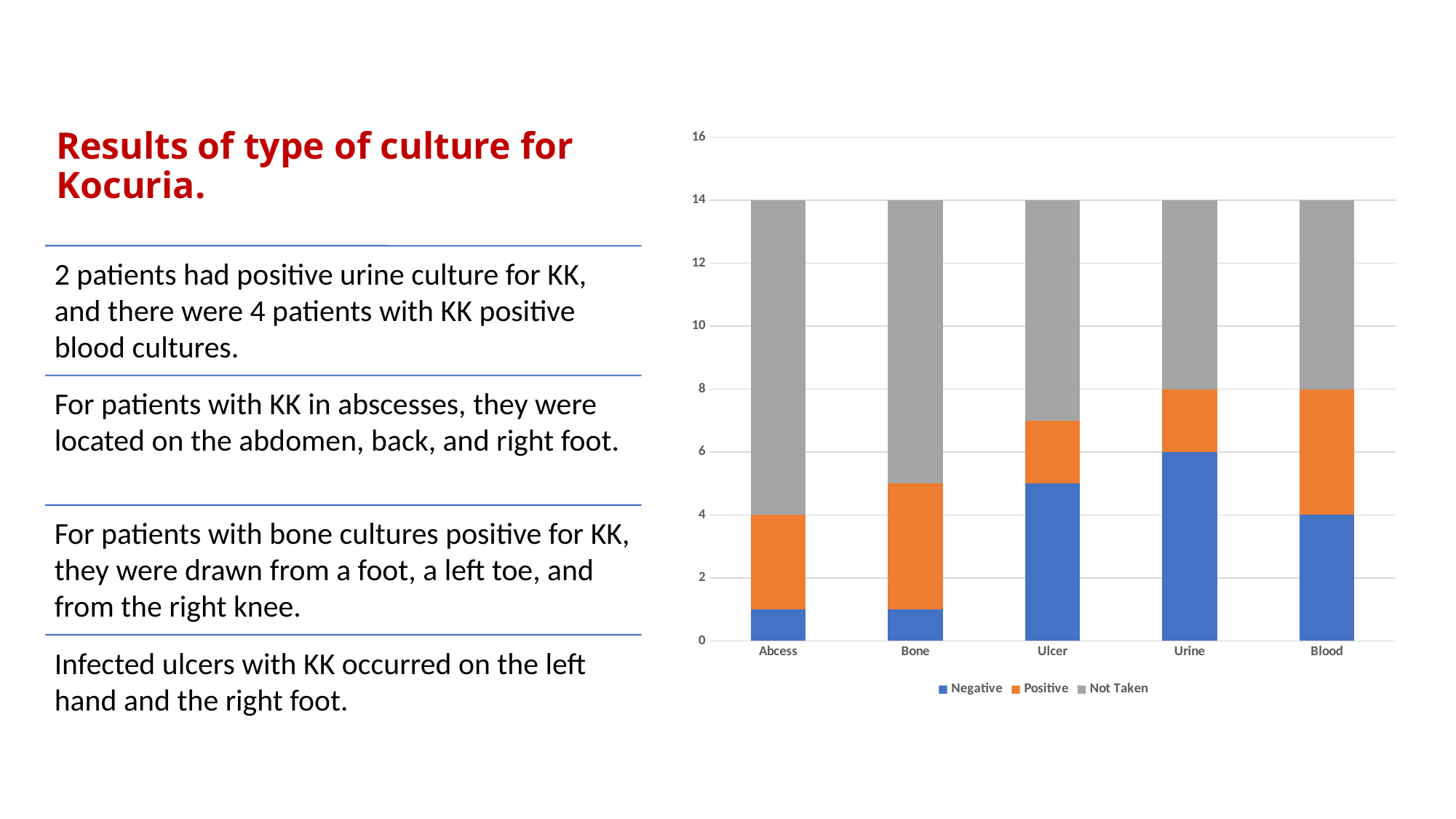
Which series is shown in gray in the chart? Not Taken Which category has the highest Negative value? Urine What is the Negative value for Urine? 6 Which series is listed first in the chart legend? Negative How many series does the chart legend list? 3 Is the Not Taken value for Abcess greater or less than 8? greater How many categories are shown on the x axis of the chart? 5 What kind of chart is shown on the slide? Stacked bar chart What is the total height of the stacked bar for Urine? 14 Which has the larger Negative value, Urine or Blood? Urine Is the Negative value for Abcess greater or less than 2? less What is the Negative value for Blood? 4